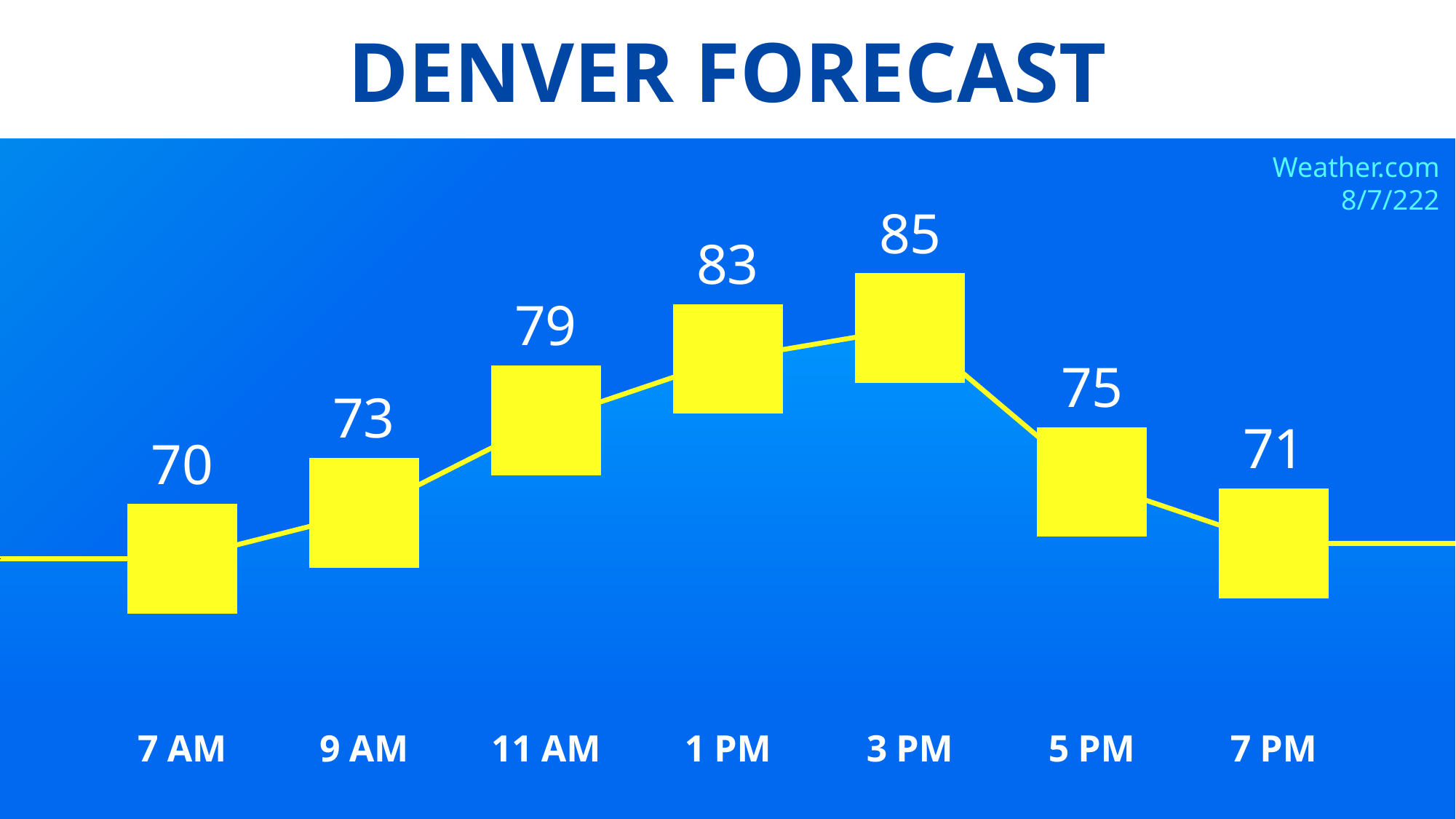
What is the title of the chart? DENVER FORECAST What is the forecast value at 7 AM? 70 What is the forecast value at 5 PM? 75 What is the difference between the values at 3 PM and 7 AM? 15 Do the values rise or fall from 7 AM to 3 PM? rise At which time is the forecast value highest? 3 PM What kind of chart is shown on the slide? line chart At which time is the forecast value lowest? 7 AM How many time points are plotted on the chart? 7 What is the forecast value at 1 PM? 83 What is the difference between the values at 11 AM and 9 AM? 6 Which is larger, the value at 9 AM or the value at 7 PM? 9 AM